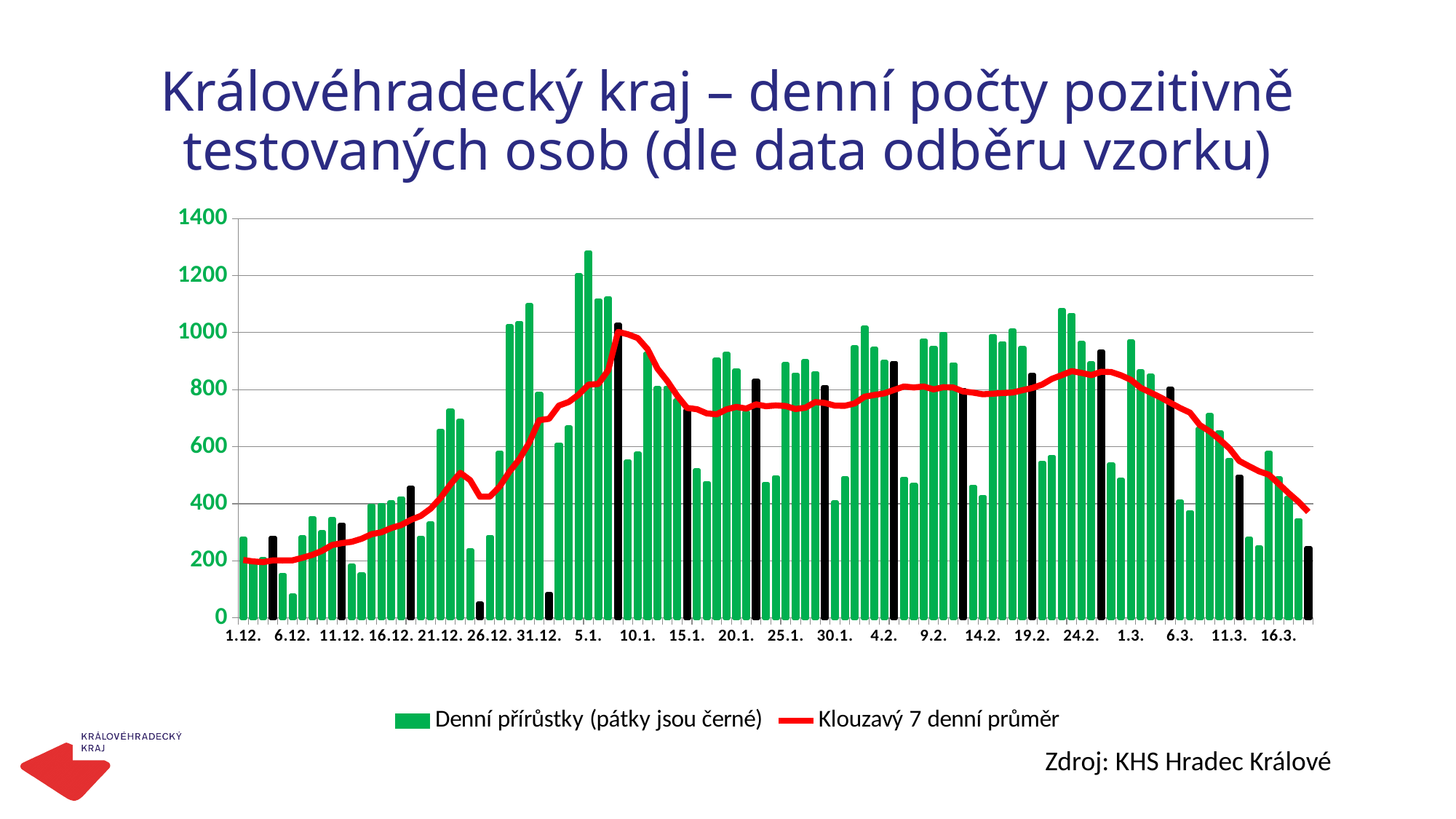
Does the 7-day moving average rise or fall between 1.3. and 16.3.? fall What kind of chart is shown on the slide? A bar chart combined with a line Does the 7-day moving average rise or fall between 1.12. and 5.1.? rise Is the daily value for 1.12. greater or less than 400? less Is the 7-day moving average at 10.1. greater or less than 800? greater Is the 7-day moving average at 16.3. greater or less than 600? less How many series does the legend list? 2 How many date labels are shown on the horizontal axis? 22 What does the red line in the chart represent, according to the legend? Klouzavý 7 denní průměr According to the legend, what colour are the bars for Fridays? Black Is the 7-day moving average higher at 10.1. or at 16.3.? 10.1. What is the highest value shown on the vertical axis? 1400